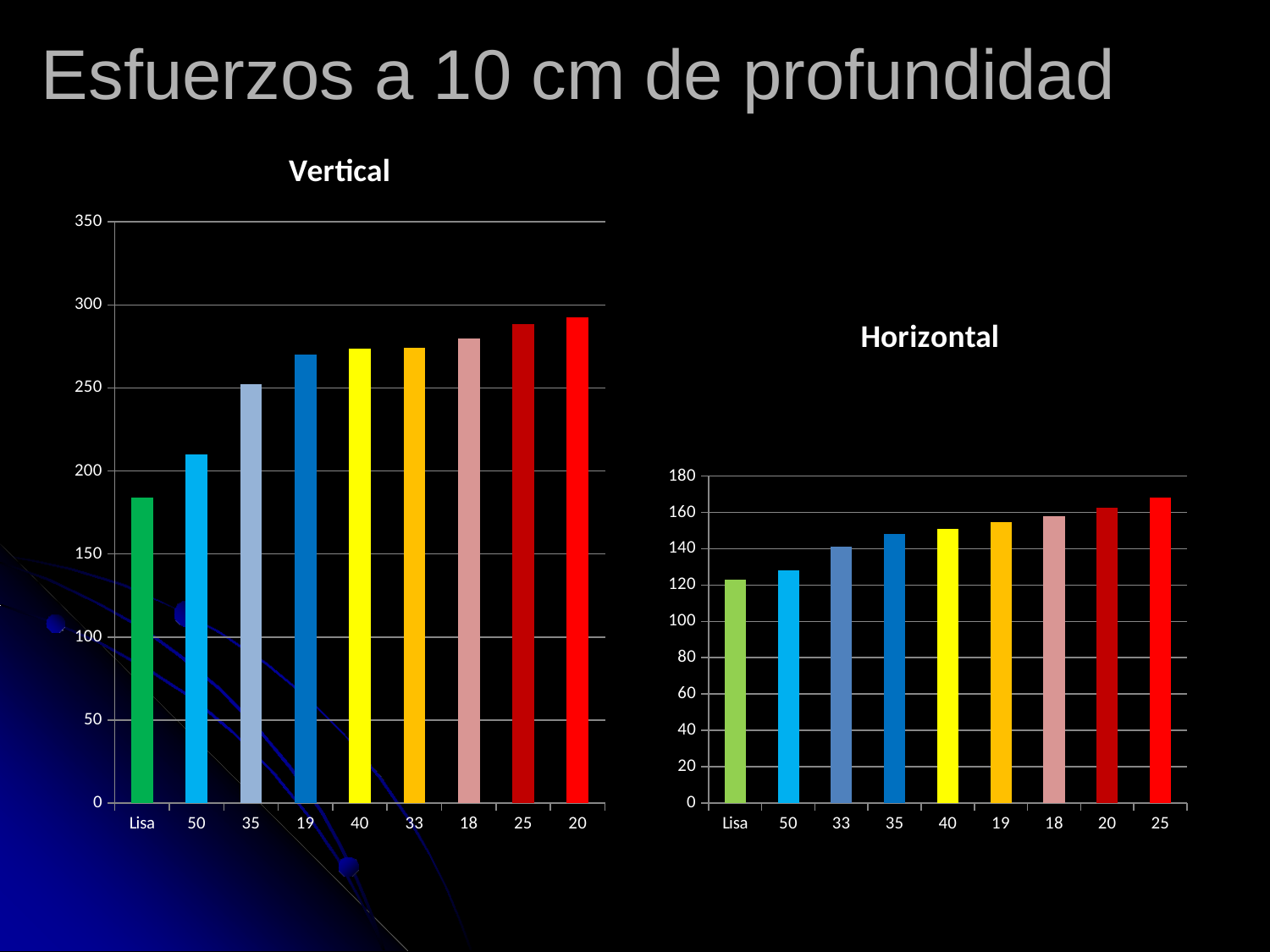
How many categories are shown on the x axis of the "Vertical" chart? 9 In the "Vertical" chart, is the value for 50 greater or less than 200? greater In the "Vertical" chart, which category has the highest bar? 20 In the "Vertical" chart, which category has the lowest bar? Lisa In the "Horizontal" chart, is the value for 50 greater or less than 140? less What kind of chart is the "Vertical" chart? bar chart How many categories are shown on the x axis of the "Horizontal" chart? 9 In the "Horizontal" chart, do the bar values generally rise or fall from left to right along the x axis? rise In the "Vertical" chart, is the value for Lisa greater or less than 200? less In the "Horizontal" chart, which category has the highest bar? 25 In the "Horizontal" chart, which category has the lowest bar? Lisa